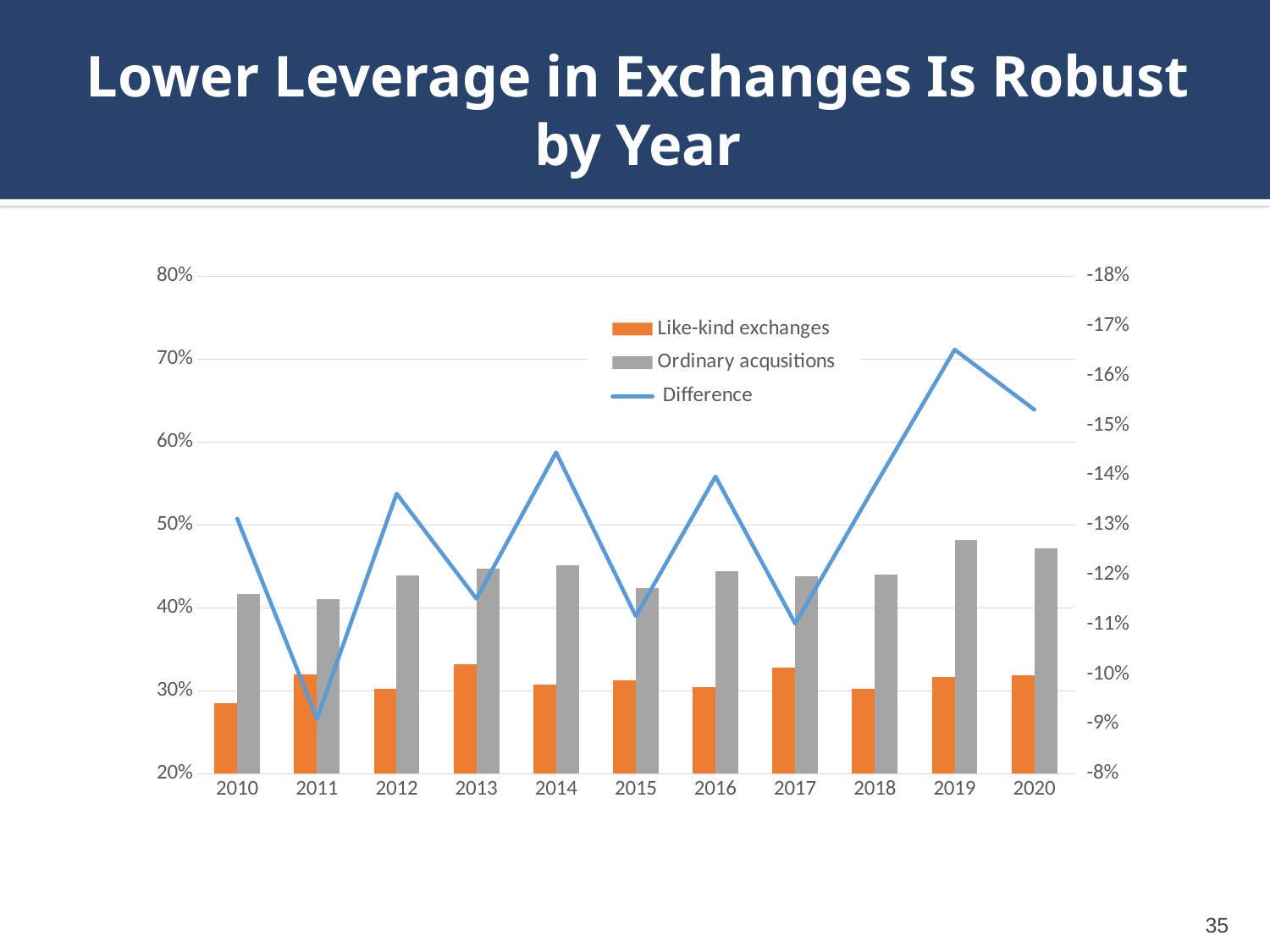
In which year is the Like-kind exchanges bar the shortest? 2010 Which is larger, the Ordinary acquisitions value in 2019 or in 2010? 2019 What colour are the Like-kind exchanges bars? Orange What type of chart is shown on the slide? A combined bar and line chart Is the value for Like-kind exchanges in 2010 greater or less than 30%? less Is the value for Like-kind exchanges in 2013 greater or less than 30%? greater In which year does the Difference line reach its lowest point? 2011 Is the value for Ordinary acquisitions in 2019 greater or less than 40%? greater How many series does the legend list? 3 How many years are shown on the x axis? 11 Which series is plotted as a line rather than bars? Difference In which year is the Ordinary acquisitions bar the tallest? 2019